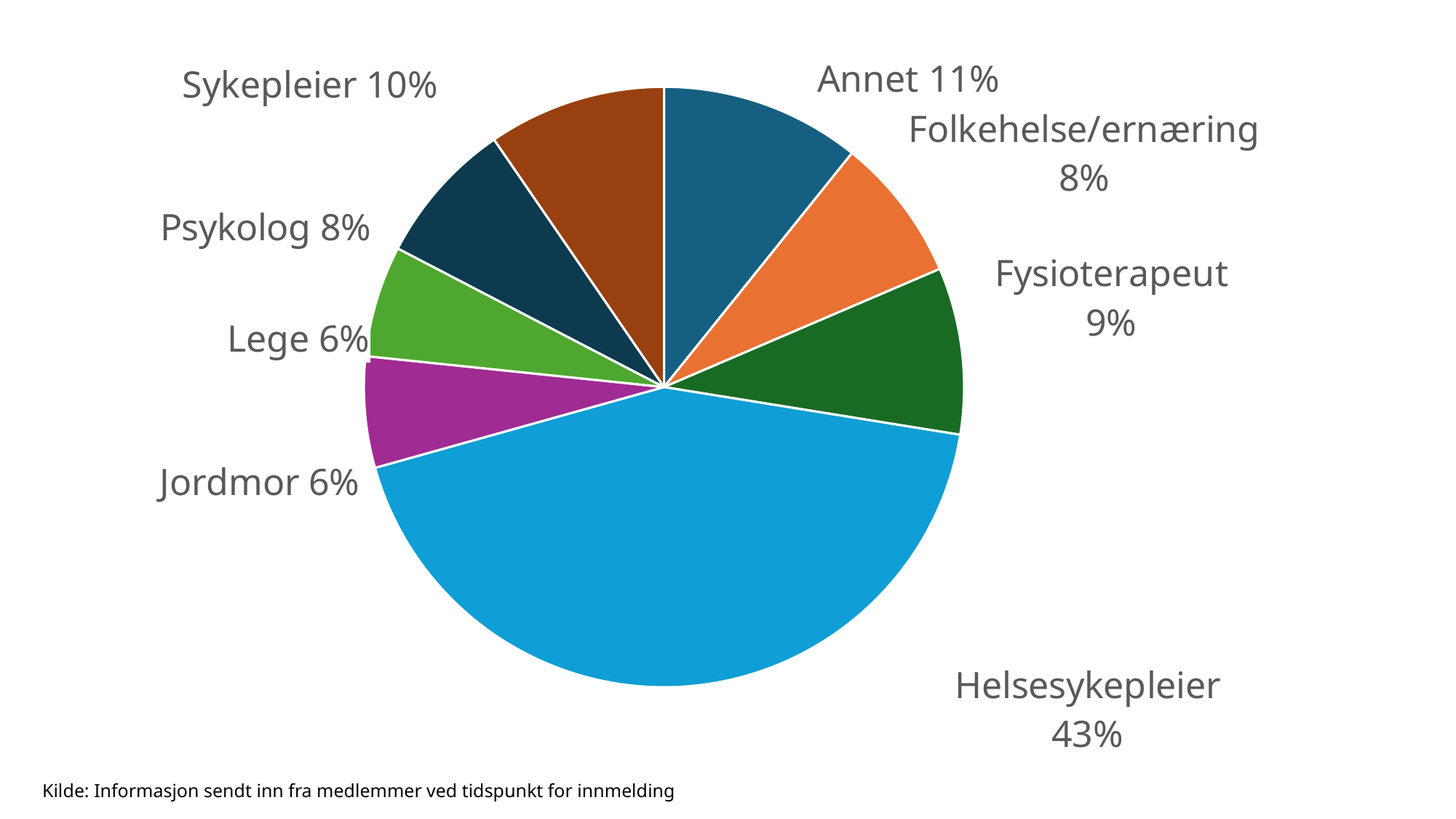
What is the difference between the shares of Sykepleier and Lege? 4% What is the value shown for Folkehelse/ernæring? 8% What is the difference between the shares of Helsesykepleier and Annet? 32% How many slices does the pie chart have? 8 What share of the pie does Helsesykepleier have? 43% What is the value shown for Sykepleier? 10% What source is cited below the chart? Kilde: Informasjon sendt inn fra medlemmer ved tidspunkt for innmelding Which category has the largest slice of the pie? Helsesykepleier What is the value shown for Fysioterapeut? 9% Which is larger, the share for Annet or the share for Fysioterapeut? Annet What is the value shown for Jordmor? 6% What kind of chart is shown on the slide? Pie chart